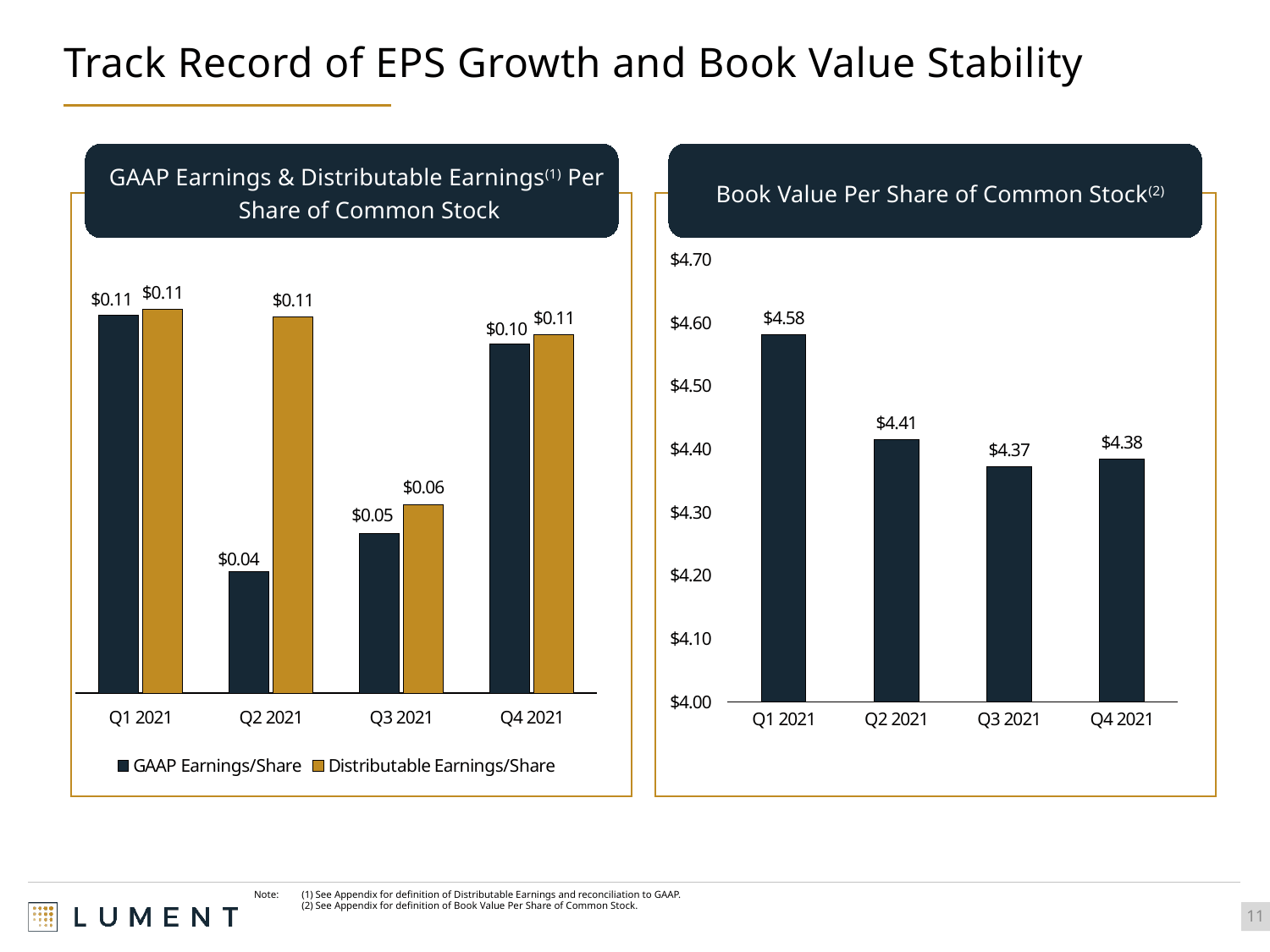
In the GAAP Earnings & Distributable Earnings Per Share chart, which quarter has the lowest GAAP Earnings/Share? Q2 2021 In the GAAP Earnings & Distributable Earnings Per Share chart, what is the Distributable Earnings/Share value for Q3 2021? $0.06 In the Book Value Per Share of Common Stock chart, which quarter has the lowest book value per share? Q3 2021 In the Book Value Per Share of Common Stock chart, is the value for Q2 2021 greater or less than $4.50? less In the GAAP Earnings & Distributable Earnings Per Share chart, how many series does the legend list? 2 In the Book Value Per Share of Common Stock chart, what is the value for Q1 2021? $4.58 In the GAAP Earnings & Distributable Earnings Per Share chart, how many quarters are shown on the x axis? 4 In the Book Value Per Share of Common Stock chart, what is the difference between the Q1 2021 and Q4 2021 values? $0.20 In the GAAP Earnings & Distributable Earnings Per Share chart, which colour represents Distributable Earnings/Share? Gold What kind of chart is the Book Value Per Share of Common Stock chart? Bar chart In the GAAP Earnings & Distributable Earnings Per Share chart, what is the GAAP Earnings/Share value for Q2 2021? $0.04 In the GAAP Earnings & Distributable Earnings Per Share chart, what is the difference between Distributable Earnings/Share and GAAP Earnings/Share in Q2 2021? $0.07